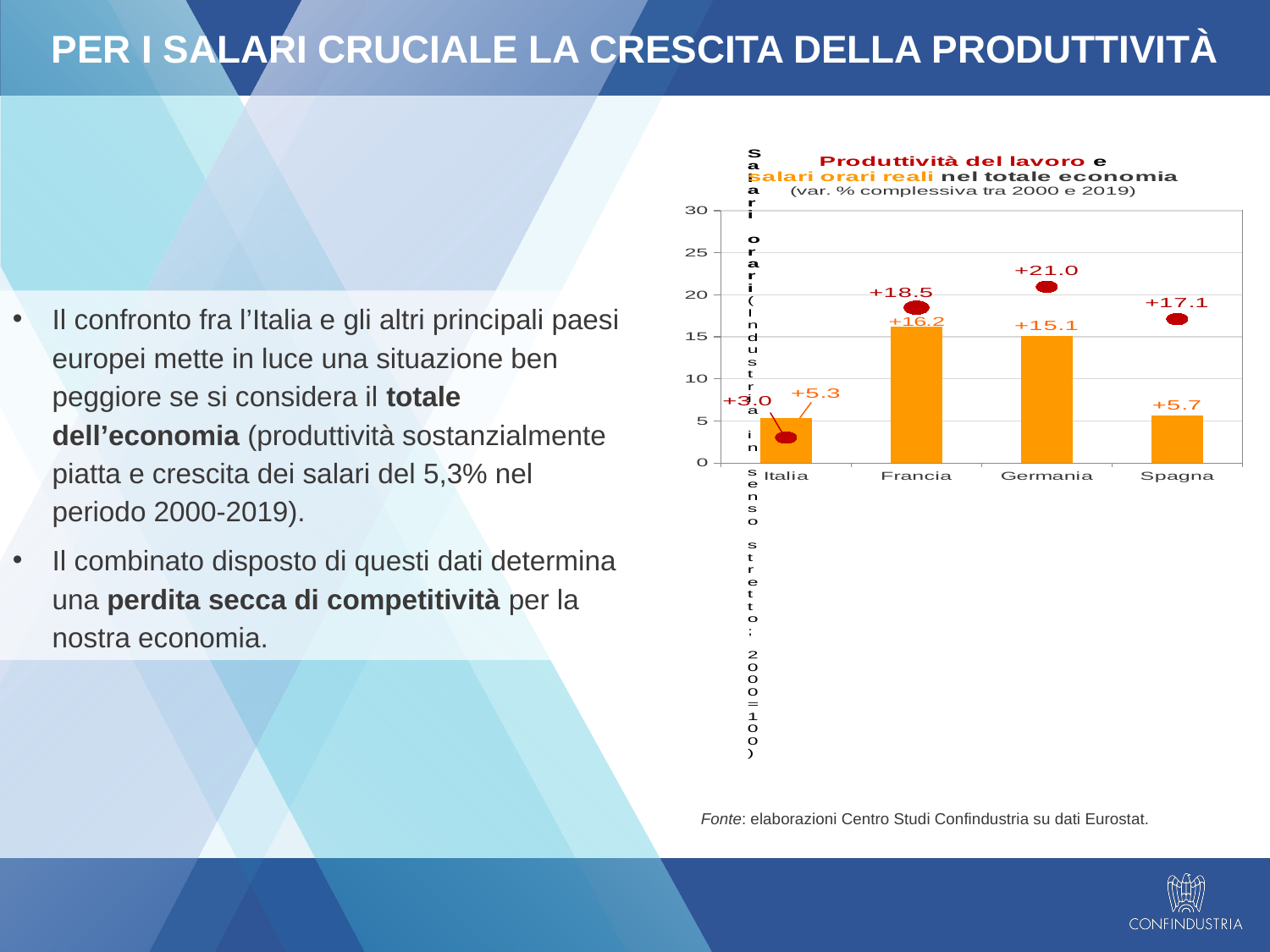
For Germania, which is larger: labour productivity or real hourly wages? Labour productivity (+21.0) Which country has the highest labour productivity growth in the chart? Germania What is the real hourly wages value shown for Spagna? +5.7 What is the labour productivity (produttività del lavoro) value shown for Germania? +21.0 How many countries are shown on the x axis of the chart? 4 What is the value of the real hourly wages (salari orari reali) bar for Francia? +16.2 Is the real hourly wages value for Germania greater or less than 10? greater Which two years does the chart's subtitle say the cumulative percentage change is measured between? 2000 and 2019 What is the labour productivity value shown for Spagna? +17.1 Which country has the lowest real hourly wage growth in the chart? Italia For Francia, how much larger is the labour productivity value than the real hourly wages value? 2.3 For Spagna, what is the difference between the labour productivity value and the real hourly wages value? 11.4